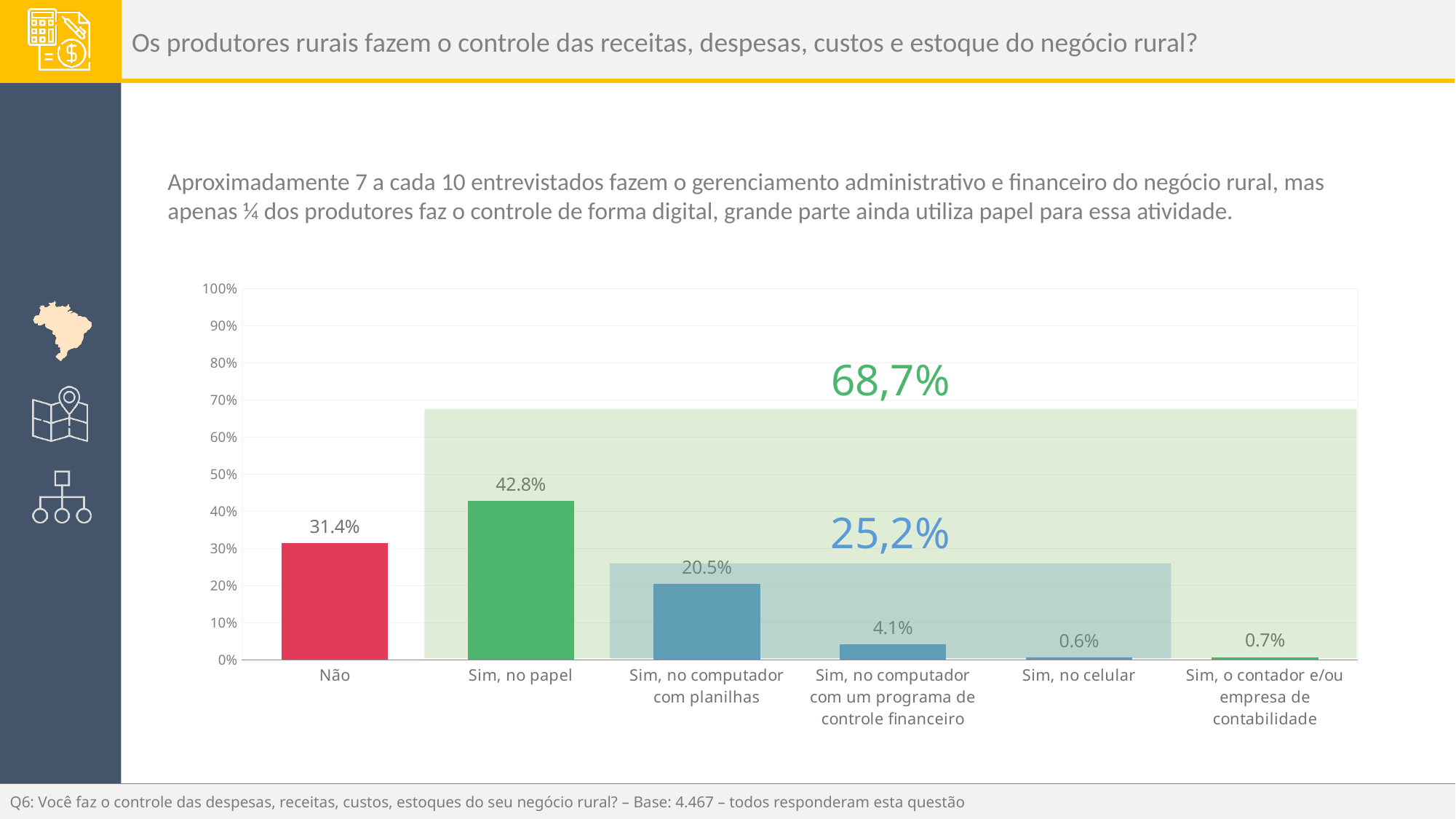
How many categories are shown on the x axis? 6 What is the value for "Sim, no celular"? 0.6% What is the value for "Sim, no papel"? 42.8% What is the difference between the values for "Sim, no papel" and "Não"? 11.4% Which category has the highest value? Sim, no papel What kind of chart is shown on the slide? Bar chart What is the value for "Não"? 31.4% Which category has the lowest value? Sim, no celular What is the value for "Sim, no computador com um programa de controle financeiro"? 4.1% What is the value for "Sim, no computador com planilhas"? 20.5% Which is larger, the value for "Não" or the value for "Sim, no computador com planilhas"? Não What percentage is shown in the large green label above the shaded area covering all the "Sim" categories? 68,7%